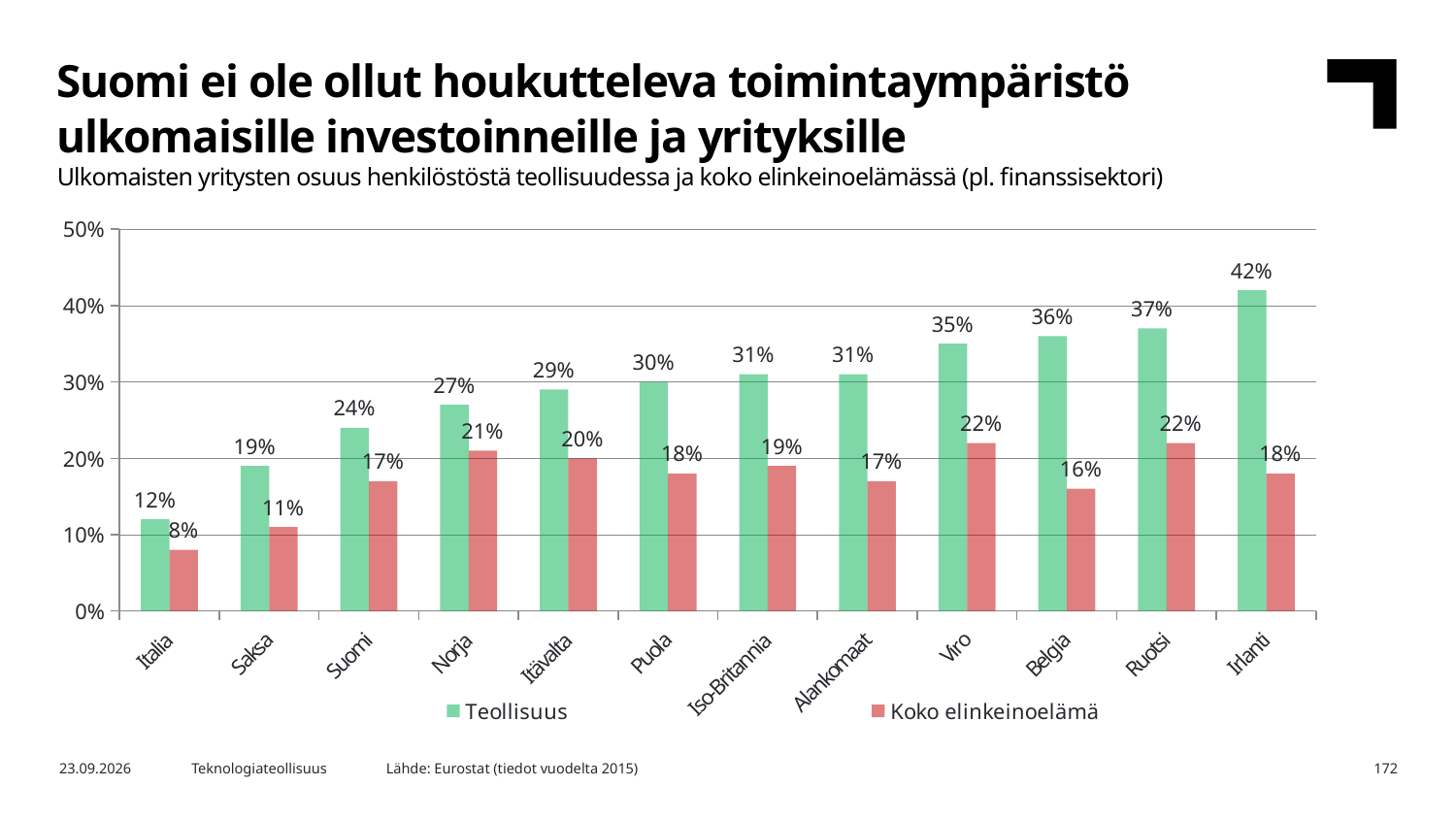
Is the Teollisuus value for Puola greater or less than 20%? greater What is the Teollisuus value for Suomi? 24% How many series does the legend list? 2 What is the Koko elinkeinoelämä value for Norja? 21% Which country has the highest Teollisuus value? Irlanti What kind of chart is shown on the slide? Bar chart Which series is shown in green in the legend? Teollisuus How many countries are shown on the x axis? 12 What is the Teollisuus value for Belgia? 36% What is the difference between the Teollisuus and Koko elinkeinoelämä values for Irlanti? 24 percentage points Which is larger, the Teollisuus value for Viro or the Teollisuus value for Ruotsi? Ruotsi Which country has the lowest Koko elinkeinoelämä value? Italia